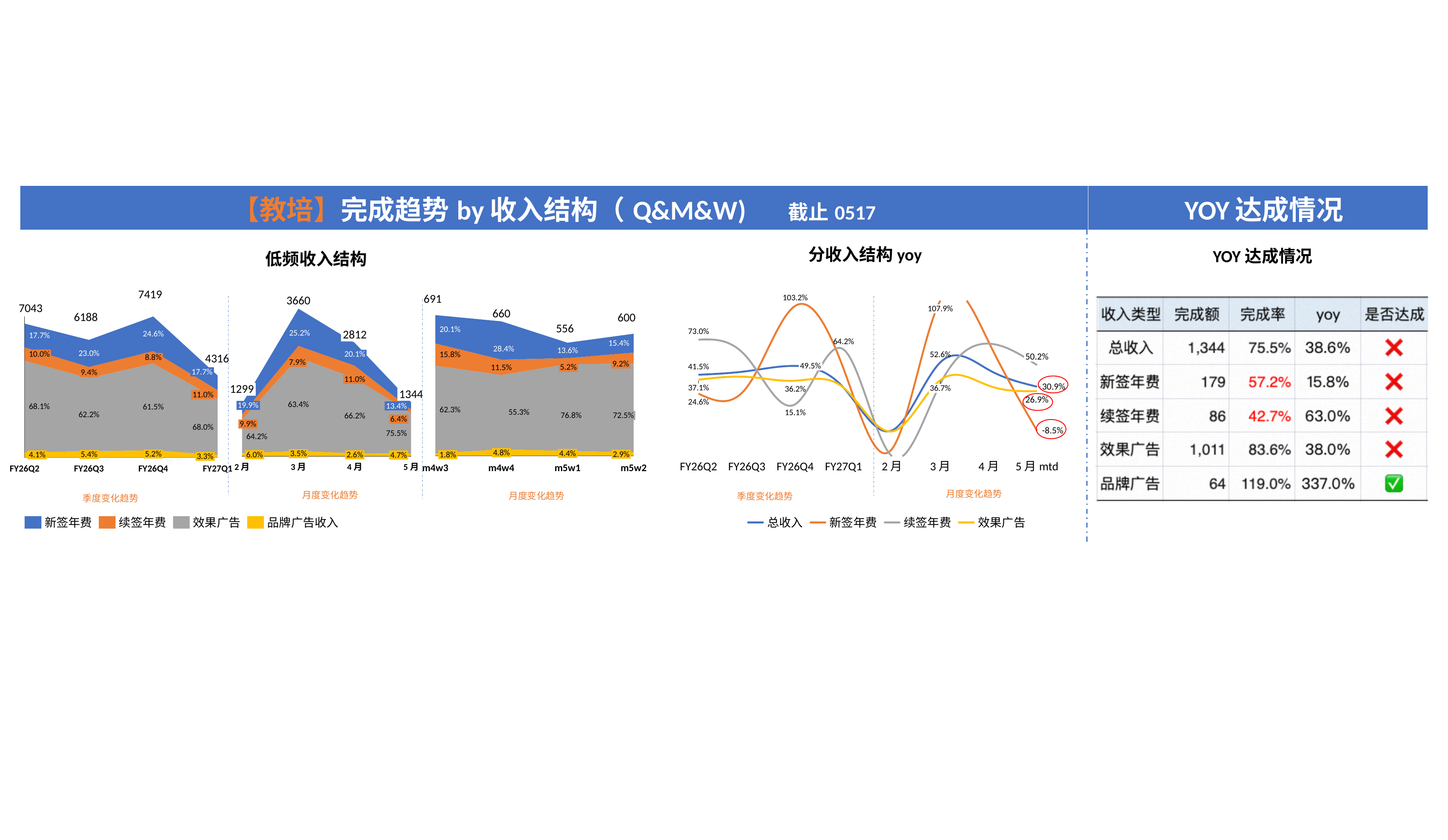
In the 低频收入结构 chart (weekly panel), what is the total for m5w1? 556 In the 低频收入结构 chart (quarterly panel), which quarter has the lowest total? FY27Q1 What kind of chart is the 分收入结构 yoy chart? line chart In the 低频收入结构 chart (monthly panel), what share does 效果广告 have in 5月? 75.5% In the 低频收入结构 chart (quarterly panel), what is the total value shown for FY26Q4? 7419 In the 低频收入结构 chart (weekly panel), which is larger, the 新签年费 share in m4w4 or in m5w1? m4w4 In the 低频收入结构 chart (quarterly panel), what is the difference between the FY26Q4 total and the FY26Q3 total? 1231 In the 低频收入结构 chart (monthly panel), which month has the highest total? 3月 In the 分收入结构 yoy chart, what is the 总收入 yoy value at 5月 mtd? 30.9% In the YOY 达成情况 table, what is the 完成率 for 品牌广告? 119.0% In the 分收入结构 yoy chart, what is the 新签年费 yoy value at 3月? 107.9% How many series does the legend of the 低频收入结构 chart list? 4